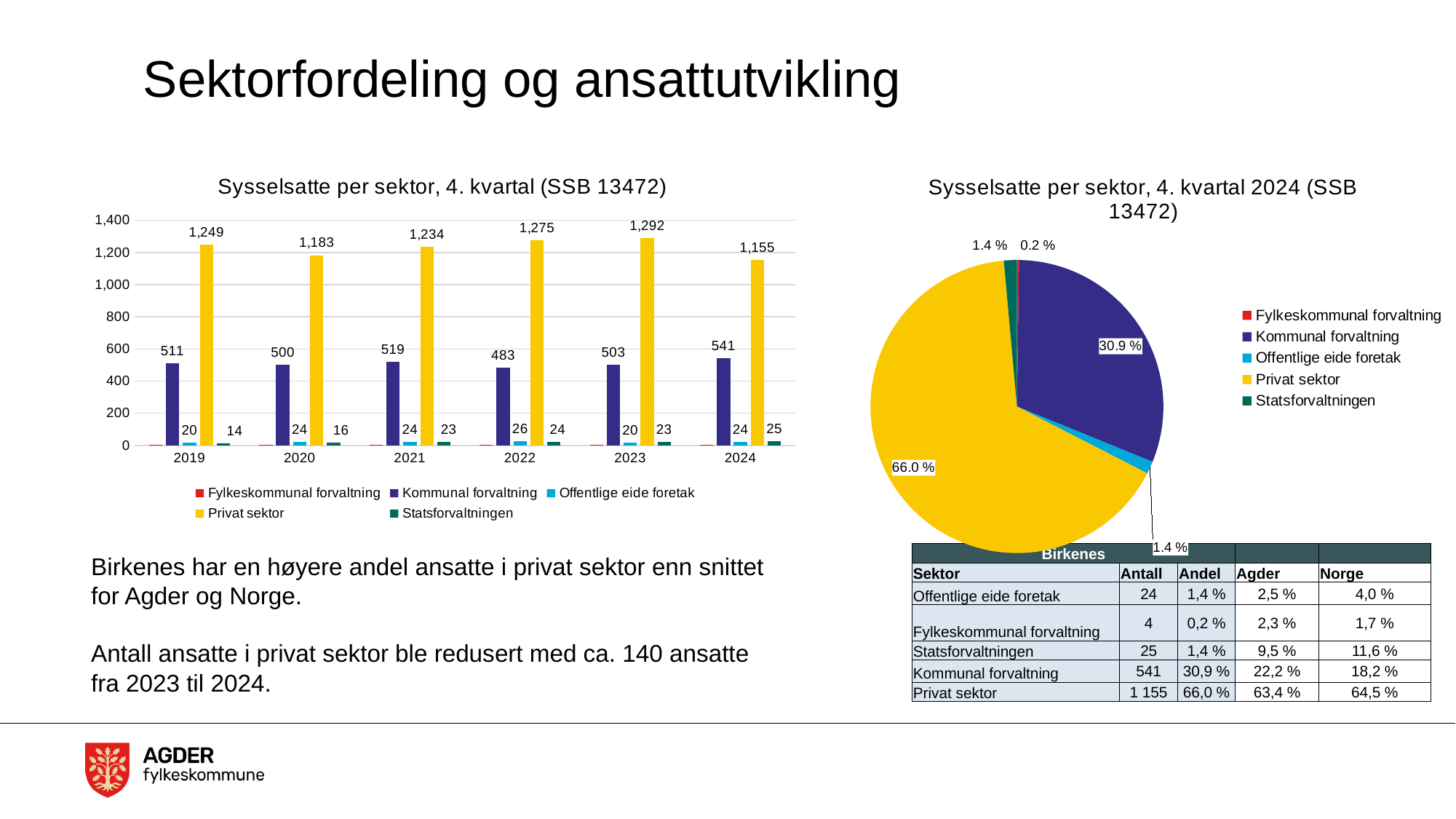
In the bar chart 'Sysselsatte per sektor, 4. kvartal (SSB 13472)', what is the value for Privat sektor in 2023? 1,292 In the bar chart 'Sysselsatte per sektor, 4. kvartal (SSB 13472)', what is the difference between the Privat sektor values for 2023 and 2024? 137 In the pie chart 'Sysselsatte per sektor, 4. kvartal 2024 (SSB 13472)', what share does Kommunal forvaltning have? 30.9 % What kind of chart is 'Sysselsatte per sektor, 4. kvartal 2024 (SSB 13472)' on the right of the slide? Pie chart In the bar chart 'Sysselsatte per sektor, 4. kvartal (SSB 13472)', which year has the highest value for Privat sektor? 2023 In the bar chart 'Sysselsatte per sektor, 4. kvartal (SSB 13472)', what is the value for Kommunal forvaltning in 2024? 541 In the bar chart 'Sysselsatte per sektor, 4. kvartal (SSB 13472)', what is the value for Statsforvaltningen in 2019? 14 In the pie chart 'Sysselsatte per sektor, 4. kvartal 2024 (SSB 13472)', what share does Privat sektor have? 66.0 % In the bar chart 'Sysselsatte per sektor, 4. kvartal (SSB 13472)', how many series does the legend list? 5 In the bar chart 'Sysselsatte per sektor, 4. kvartal (SSB 13472)', is the Privat sektor value for 2020 greater or less than 1,200? less In the bar chart 'Sysselsatte per sektor, 4. kvartal (SSB 13472)', how many years are shown on the x axis? 6 In the bar chart 'Sysselsatte per sektor, 4. kvartal (SSB 13472)', which year has the lowest value for Kommunal forvaltning? 2022